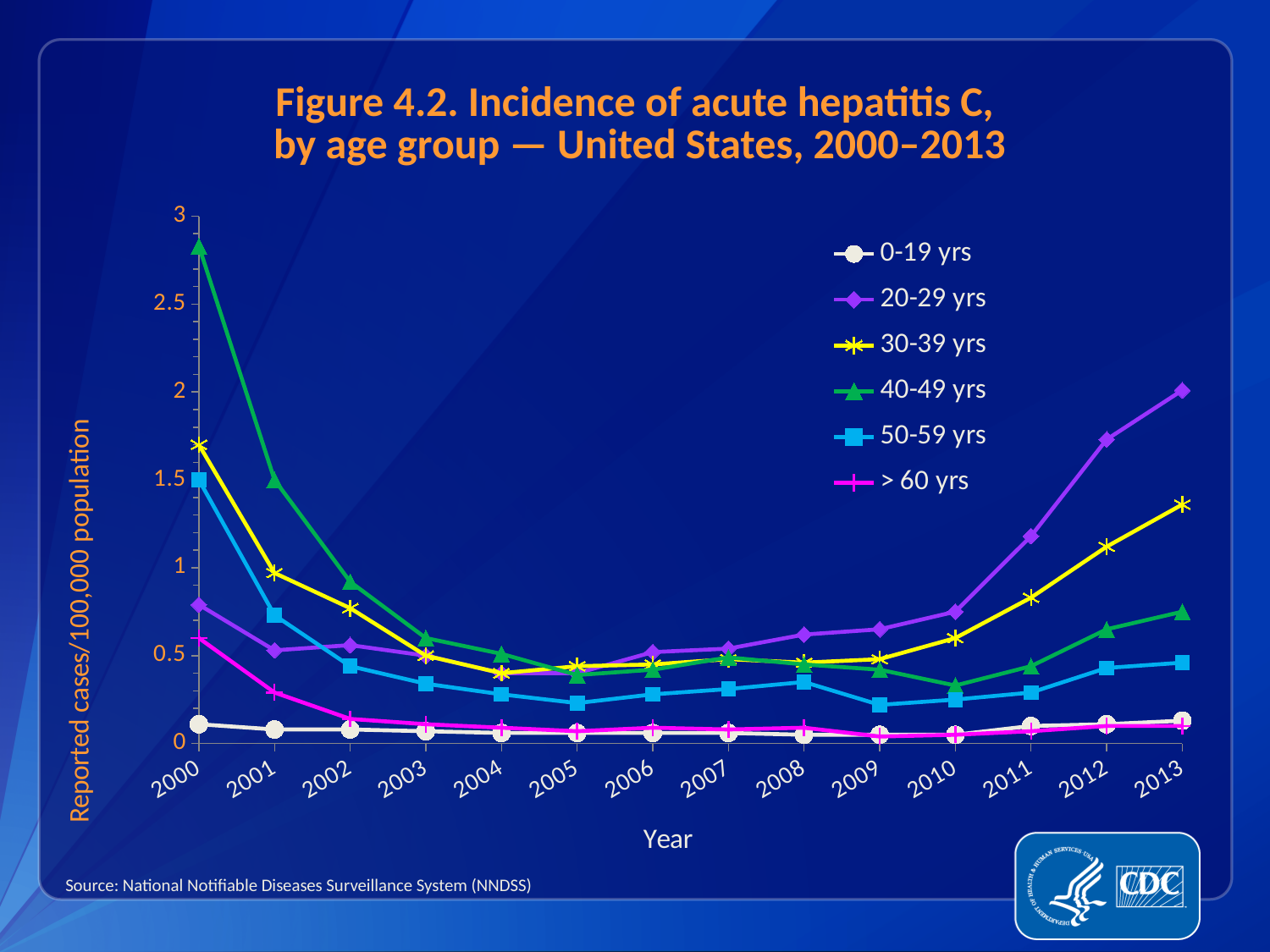
In 2013, which is larger: the value for 30-39 yrs or the value for 40-49 yrs? 30-39 yrs How many years are plotted along the x axis? 14 What kind of chart is shown on the slide? line chart Is the value for 40-49 yrs in 2000 greater or less than 2.5? greater How many age-group series does the legend list? 6 Which age group had the highest incidence in 2013? 20-29 yrs What is the label of the y axis? Reported cases/100,000 population Is the value for 30-39 yrs in 2013 greater or less than 1? greater Is the value for 50-59 yrs in 2000 greater or less than 1? greater Does the 20-29 yrs line rise or fall from 2010 to 2013? rise Which age group had the lowest incidence in 2000? 0-19 yrs Which age group had the highest incidence in 2000? 40-49 yrs